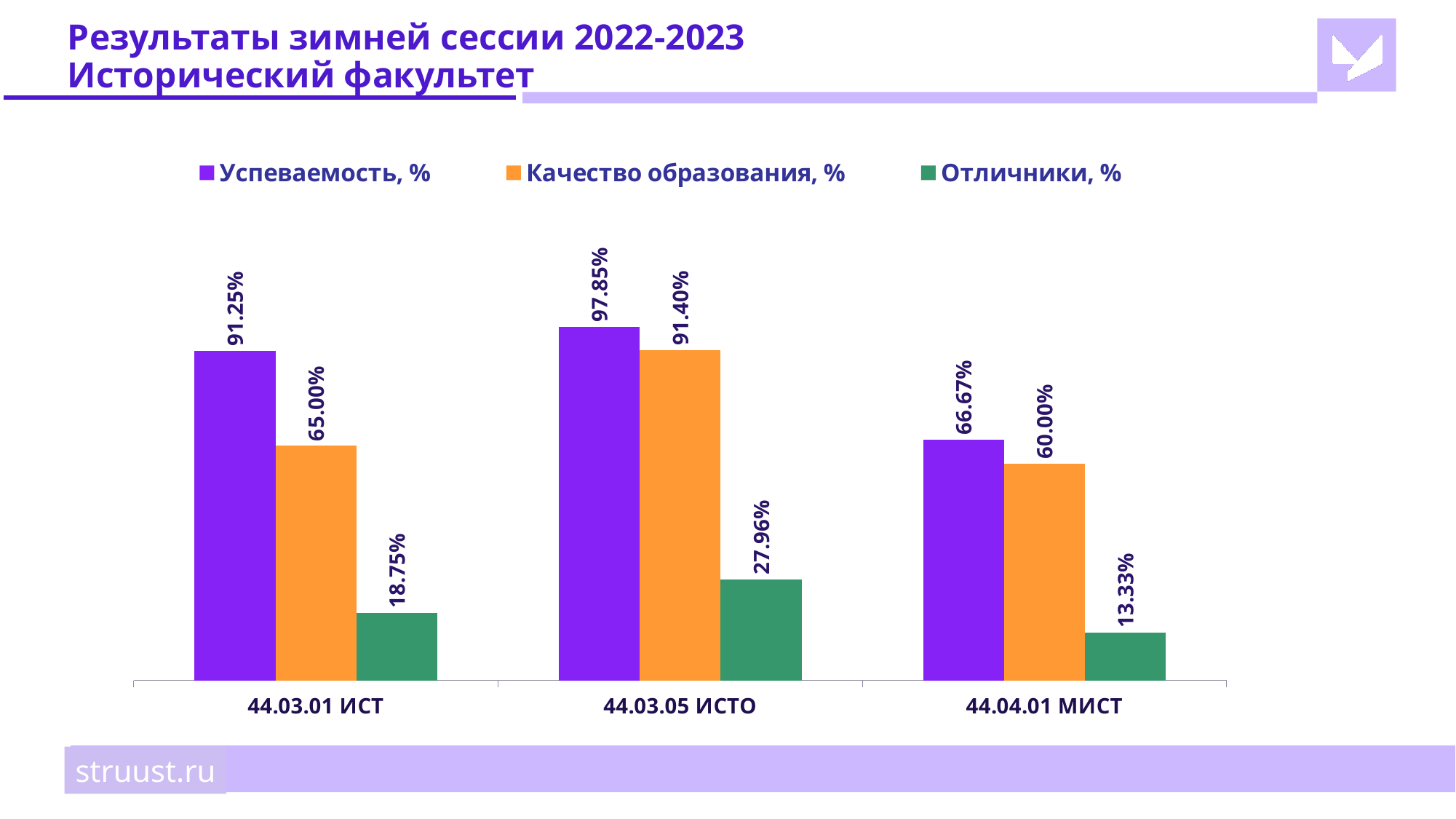
What is the Отличники, % value for 44.04.01 МИСТ? 13.33% Which category has the lowest Отличники, % value? 44.04.01 МИСТ How many series does the legend list? 3 What is the difference between the Успеваемость, % and Качество образования, % values for 44.03.01 ИСТ? 26.25% Which colour represents the Отличники, % series in the legend? Green Which category has the highest Успеваемость, % value? 44.03.05 ИСТО How many categories are shown on the x axis? 3 What is the Качество образования, % value for 44.03.05 ИСТО? 91.40% What kind of chart is shown on the slide? Bar chart Which is larger: the Отличники, % value for 44.03.01 ИСТ or for 44.03.05 ИСТО? 44.03.05 ИСТО What is the Успеваемость, % value for 44.03.01 ИСТ? 91.25% What is the Качество образования, % value for 44.04.01 МИСТ? 60.00%